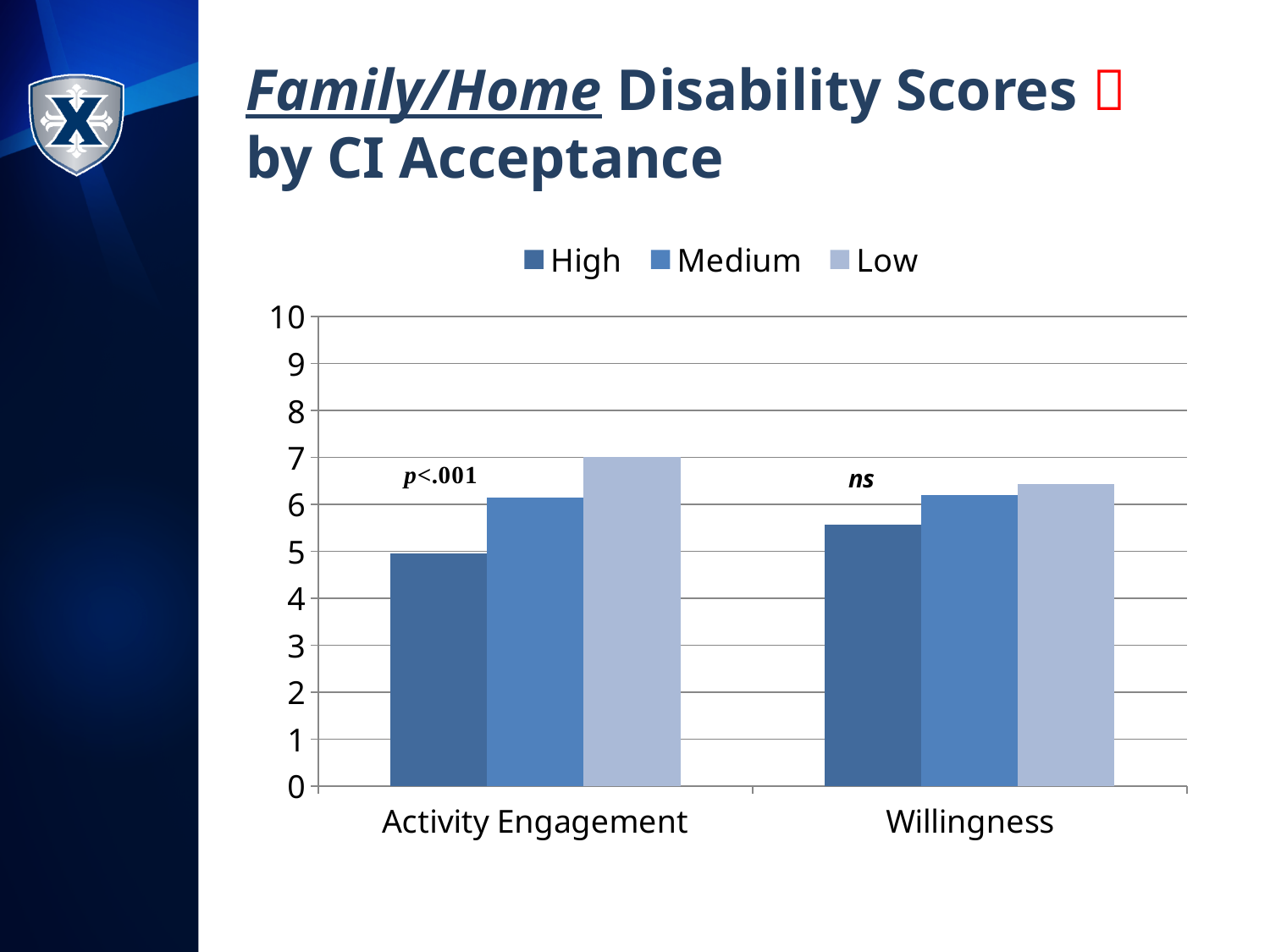
Is the value for High in Willingness greater or less than 6? less Which series has the lowest value for Activity Engagement? High Is the value for Low in Activity Engagement greater or less than 6? greater Which is larger: the Low value for Activity Engagement or the Low value for Willingness? Activity Engagement Which series has the lowest value for Willingness? High Is the value for High in Activity Engagement greater or less than 6? less How many series does the legend list? 3 How many categories are shown on the x axis? 2 What annotation is printed above the Willingness bars? ns What kind of chart is shown on the slide? bar chart What significance annotation is printed above the Activity Engagement bars? p<.001 Which series has the highest value for Activity Engagement? Low